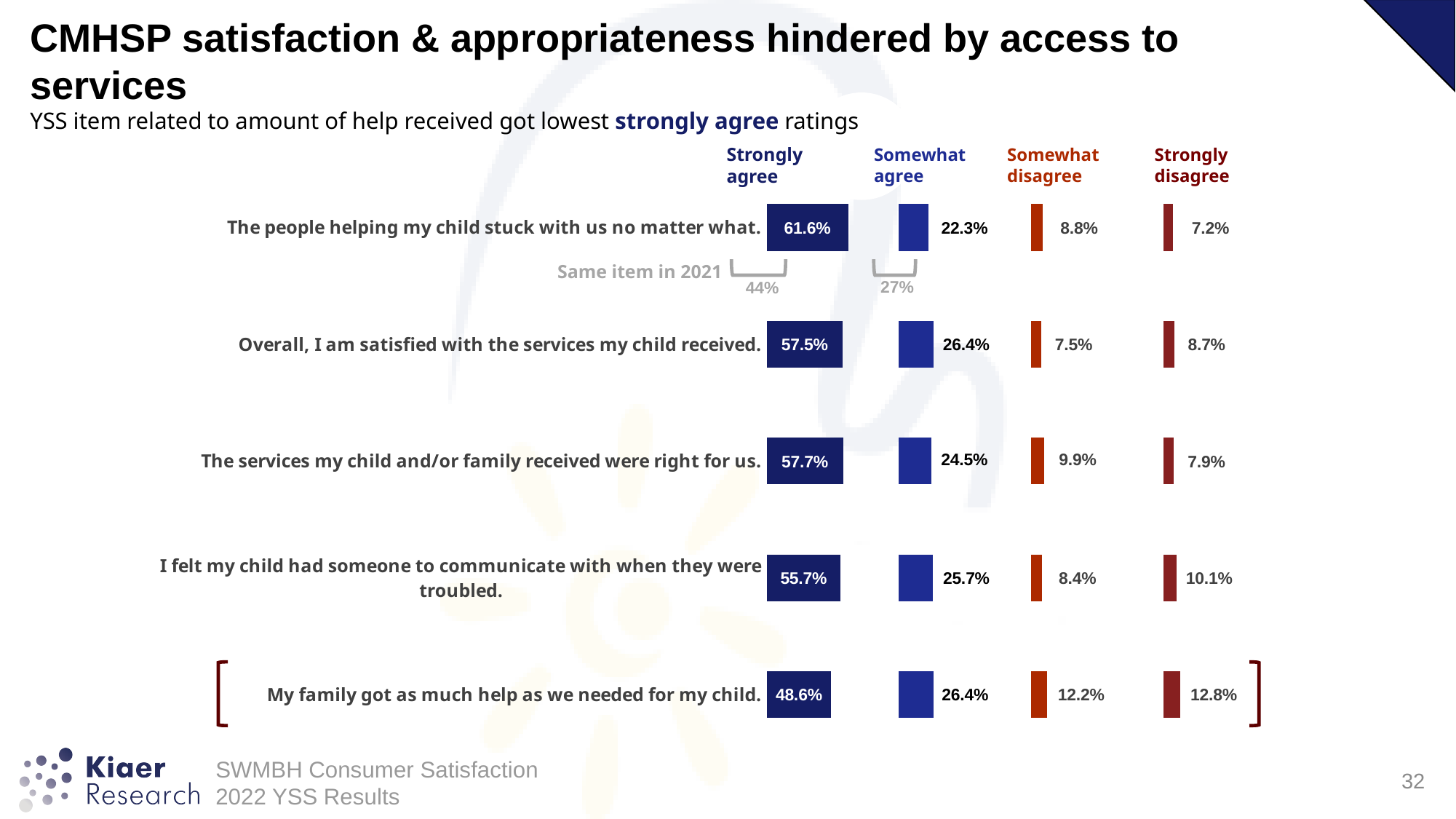
What is the somewhat agree percentage for "I felt my child had someone to communicate with when they were troubled"? 25.7% Which is larger: the strongly disagree percentage for "Overall, I am satisfied with the services my child received" or for "The services my child and/or family received were right for us"? Overall, I am satisfied with the services my child received (8.7%) Which item received the lowest strongly agree rating? My family got as much help as we needed for my child. How many survey items are shown in the chart? 5 Which item received the highest strongly agree rating? The people helping my child stuck with us no matter what. What is the difference in strongly agree percentage between "The people helping my child stuck with us no matter what" and "My family got as much help as we needed for my child"? 13.0% What is the strongly disagree percentage for the item "My family got as much help as we needed for my child"? 12.8% Which item has the highest somewhat disagree percentage? My family got as much help as we needed for my child. What was the strongly agree percentage in 2021 for the item "The people helping my child stuck with us no matter what"? 44% What type of chart is used on this slide? Bar chart How many response categories are shown across the top of the chart? 4 What percentage of respondents strongly agreed that the people helping their child stuck with them no matter what? 61.6%